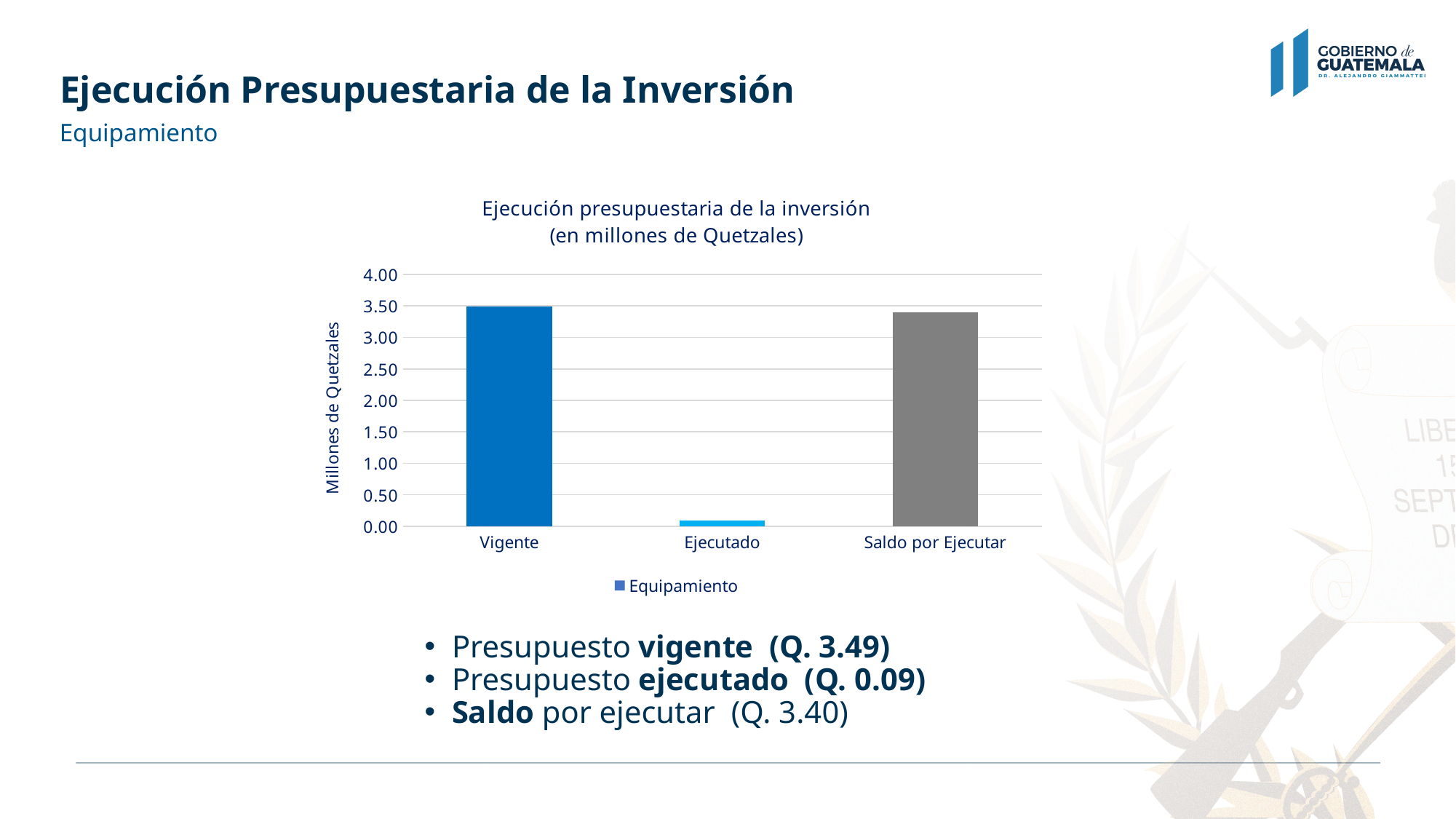
What kind of chart is shown on the slide? bar chart How many categories are shown on the x axis of the chart? 3 According to the slide, what is the presupuesto ejecutado in millions of Quetzales? Q. 0.09 Which is larger, the value for Vigente or the value for Ejecutado? Vigente Is the value for Vigente greater or less than 3.00? greater Is the value for Saldo por Ejecutar greater or less than 3.50? less According to the slide, what is the presupuesto vigente in millions of Quetzales? Q. 3.49 Is the value for Ejecutado greater or less than 0.50? less Which category has the highest value in the chart? Vigente What is the name of the series shown in the chart legend? Equipamiento How many series does the chart legend list? 1 Which category has the lowest value in the chart? Ejecutado